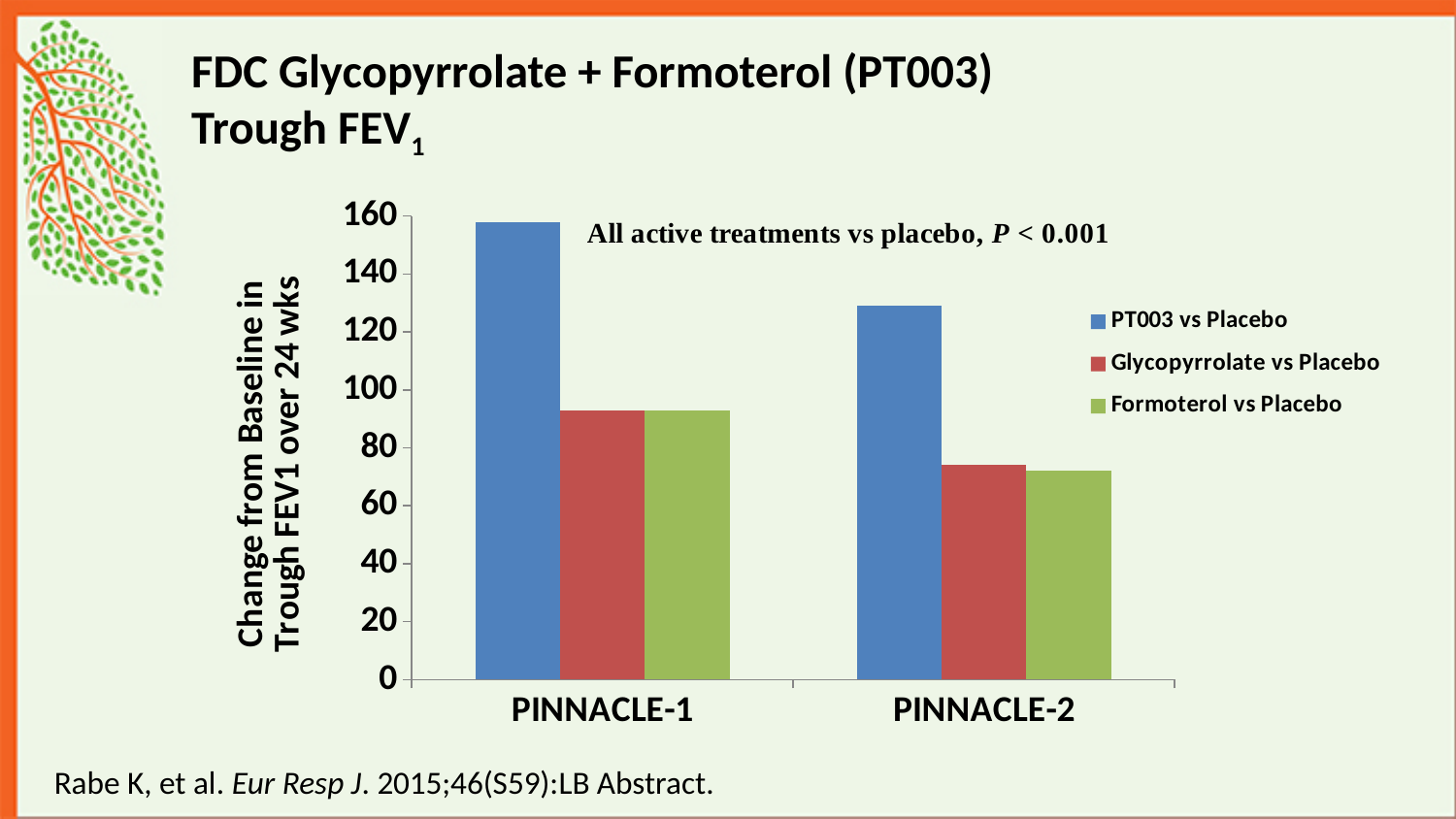
Is the value for PT003 vs Placebo in PINNACLE-2 greater or less than 120? greater Which series has the highest value in PINNACLE-2? PT003 vs Placebo How many study categories are shown on the x axis? 2 Which is larger: PT003 vs Placebo in PINNACLE-1 or PT003 vs Placebo in PINNACLE-2? PT003 vs Placebo in PINNACLE-1 What kind of chart is shown on the slide? bar chart What colour represents the PT003 vs Placebo series? blue Which is larger: Glycopyrrolate vs Placebo in PINNACLE-1 or Glycopyrrolate vs Placebo in PINNACLE-2? Glycopyrrolate vs Placebo in PINNACLE-1 How many series does the legend list? 3 Is the value for PT003 vs Placebo in PINNACLE-1 greater or less than 140? greater Is the value for Glycopyrrolate vs Placebo in PINNACLE-1 greater or less than 100? less Which series has the highest value in PINNACLE-1? PT003 vs Placebo